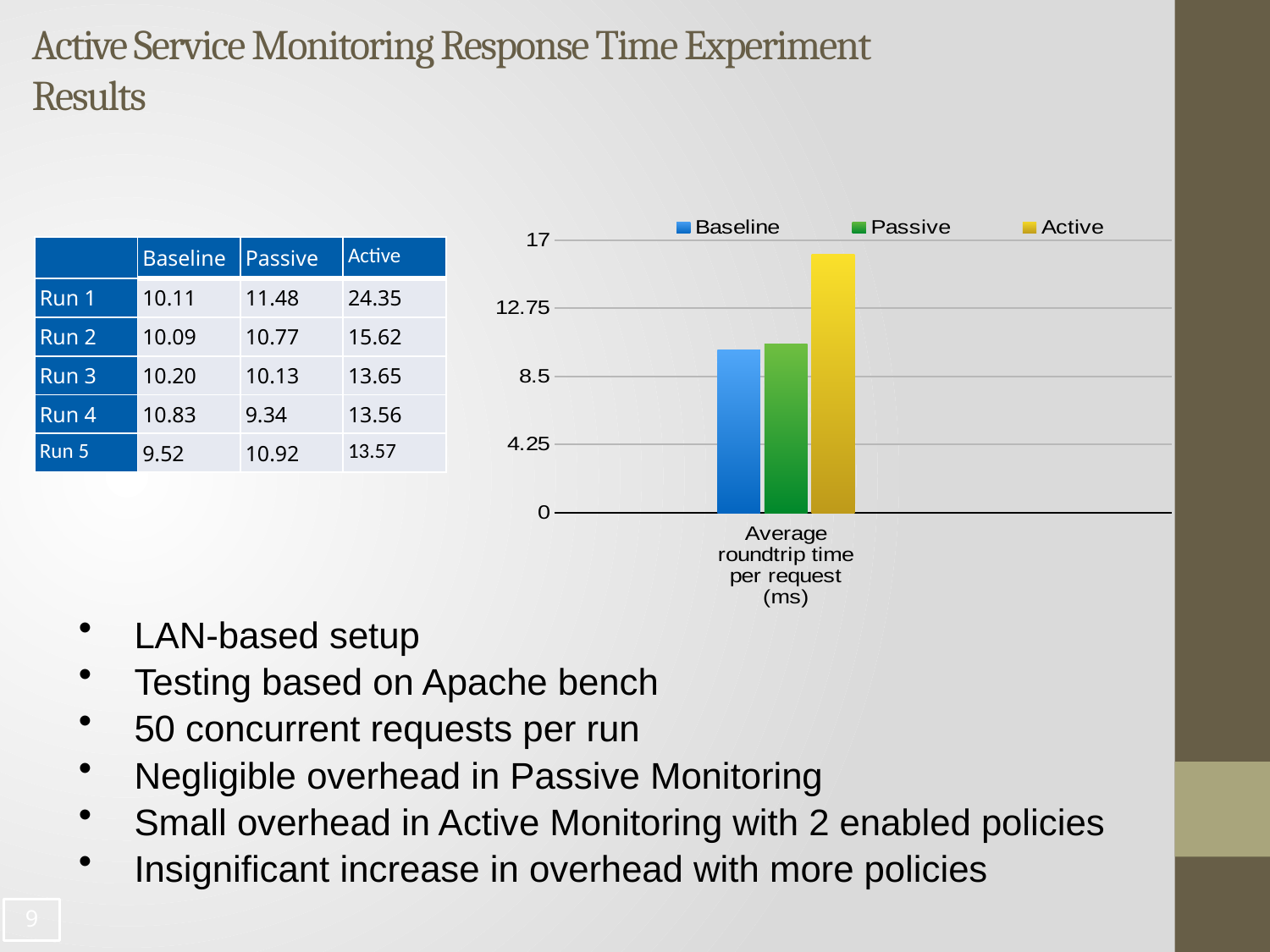
Is the value for Baseline greater or less than 8.5? greater Is the value for Active greater or less than 12.75? greater Which series has the highest bar in the chart? Active What colour is the Active series in the chart? yellow What is the label of the category on the x axis of the chart? Average roundtrip time per request (ms) Which is larger in the chart, the Passive bar or the Active bar? Active Is the value for Passive greater or less than 12.75? less How many categories are plotted on the x axis of the chart? 1 How many series does the chart legend list? 3 Which is larger in the chart, the Active bar or the Baseline bar? Active What kind of chart is shown on the slide? bar chart